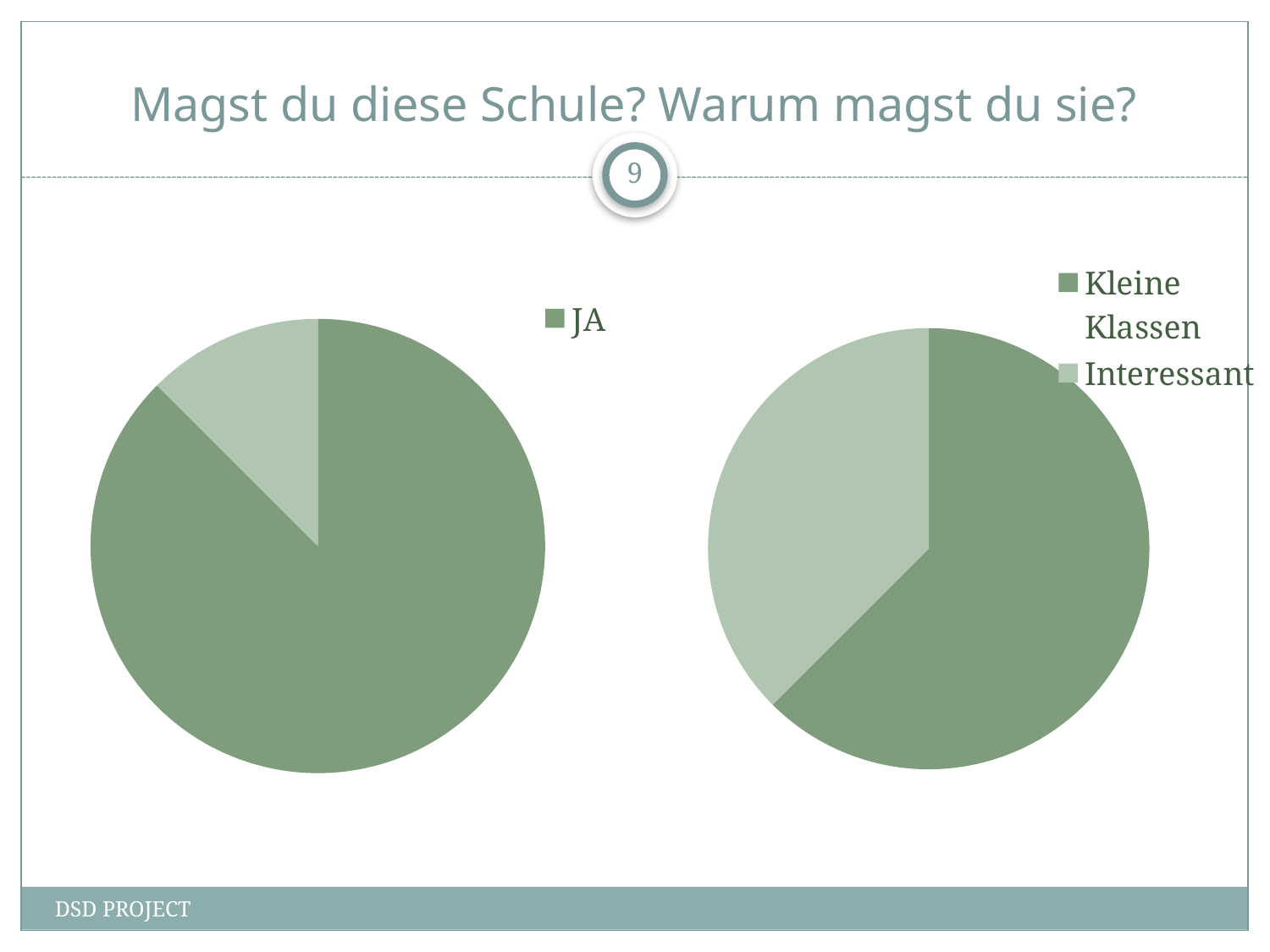
How many slices does the pie chart on the left have? 2 What kind of chart is the chart on the left of the slide? Pie chart How many slices does the pie chart on the right have? 2 What is the only legend entry shown for the pie chart on the left? JA What kind of chart is the chart on the right of the slide? Pie chart What is the title of the slide containing the two pie charts? Magst du diese Schule? Warum magst du sie? In the pie chart on the right, which slice is larger: Kleine Klassen or Interessant? Kleine Klassen In the pie chart on the right, which category has the larger slice? Kleine Klassen In the pie chart on the left, which labelled category has the larger slice? JA In the pie chart on the right, which category has the smaller slice? Interessant How many entries does the legend of the pie chart on the right list? 2 How many entries does the legend of the pie chart on the left list? 1